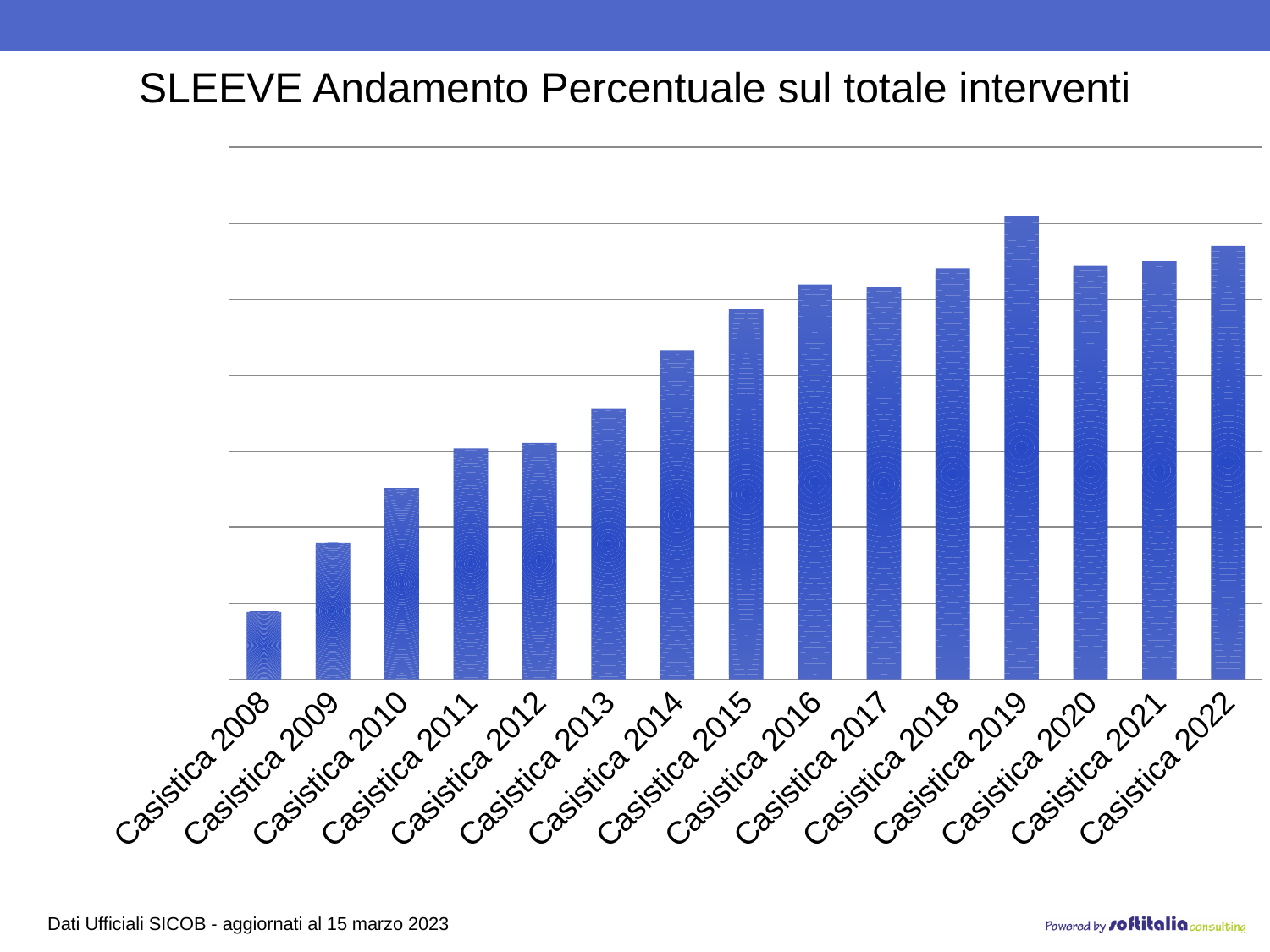
How many categories (bars) are plotted in the chart? 15 What is the title of the chart? SLEEVE Andamento Percentuale sul totale interventi Which category has the lowest bar? Casistica 2008 Which is larger, the value for Casistica 2018 or Casistica 2022? Casistica 2022 What is the source note printed at the bottom left of the slide? Dati Ufficiali SICOB - aggiornati al 15 marzo 2023 Which is larger, the value for Casistica 2008 or Casistica 2009? Casistica 2009 Which is larger, the value for Casistica 2010 or Casistica 2011? Casistica 2011 Do the values generally rise or fall from Casistica 2008 to Casistica 2019? rise Which category has the highest bar? Casistica 2019 What kind of chart is shown on the slide? bar chart